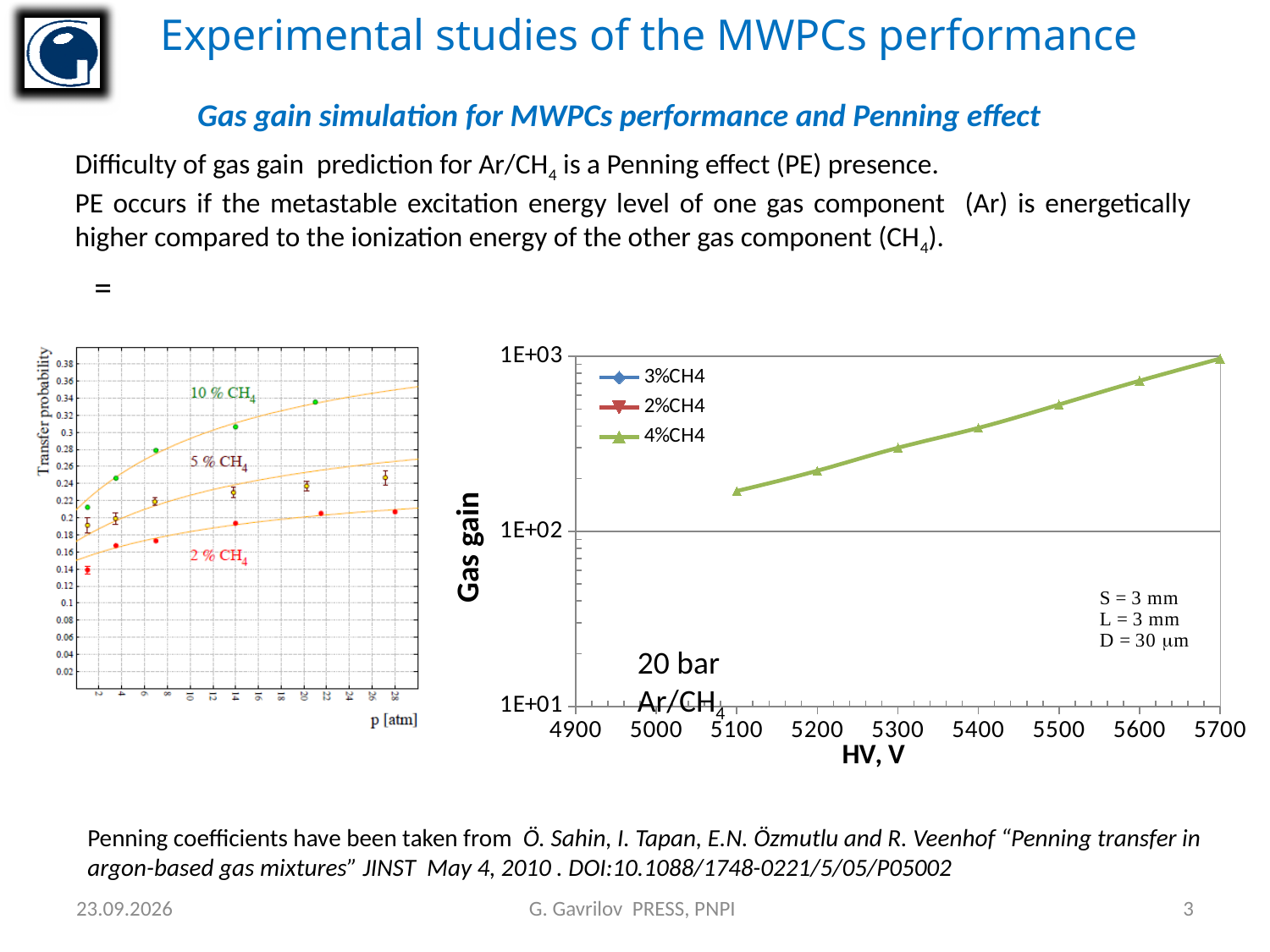
In the right-hand chart (Gas gain vs HV, V), is the gas gain for 4%CH4 at HV = 5100 V greater or less than 1E+02? greater In the left-hand chart (Transfer probability vs p [atm]), which CH4 concentration curve has the highest transfer probability? 10 % CH4 In the right-hand chart (Gas gain vs HV, V), what are the three legend entries? 3%CH4, 2%CH4, 4%CH4 In the right-hand chart (Gas gain vs HV, V), how many data points are plotted for the 4%CH4 series? 7 In the right-hand chart (Gas gain vs HV, V), at which HV value is the 4%CH4 gas gain lowest? 5100 In the right-hand chart (Gas gain vs HV, V), at which HV value is the 4%CH4 gas gain highest? 5700 In the right-hand chart (Gas gain vs HV, V), is the gas gain for 4%CH4 at HV = 5400 V greater or less than 1E+02? greater In the right-hand chart (Gas gain vs HV, V), what kind of chart is it? line chart In the right-hand chart (Gas gain vs HV, V), what is the label of the x axis? HV, V In the right-hand chart (Gas gain vs HV, V), does the plotted 4%CH4 series rise or fall as HV increases? rise In the right-hand chart (Gas gain vs HV, V), how many series does the legend list? 3 In the right-hand chart (Gas gain vs HV, V), is the gas gain for 4%CH4 at HV = 5200 V greater or less than 1E+03? less